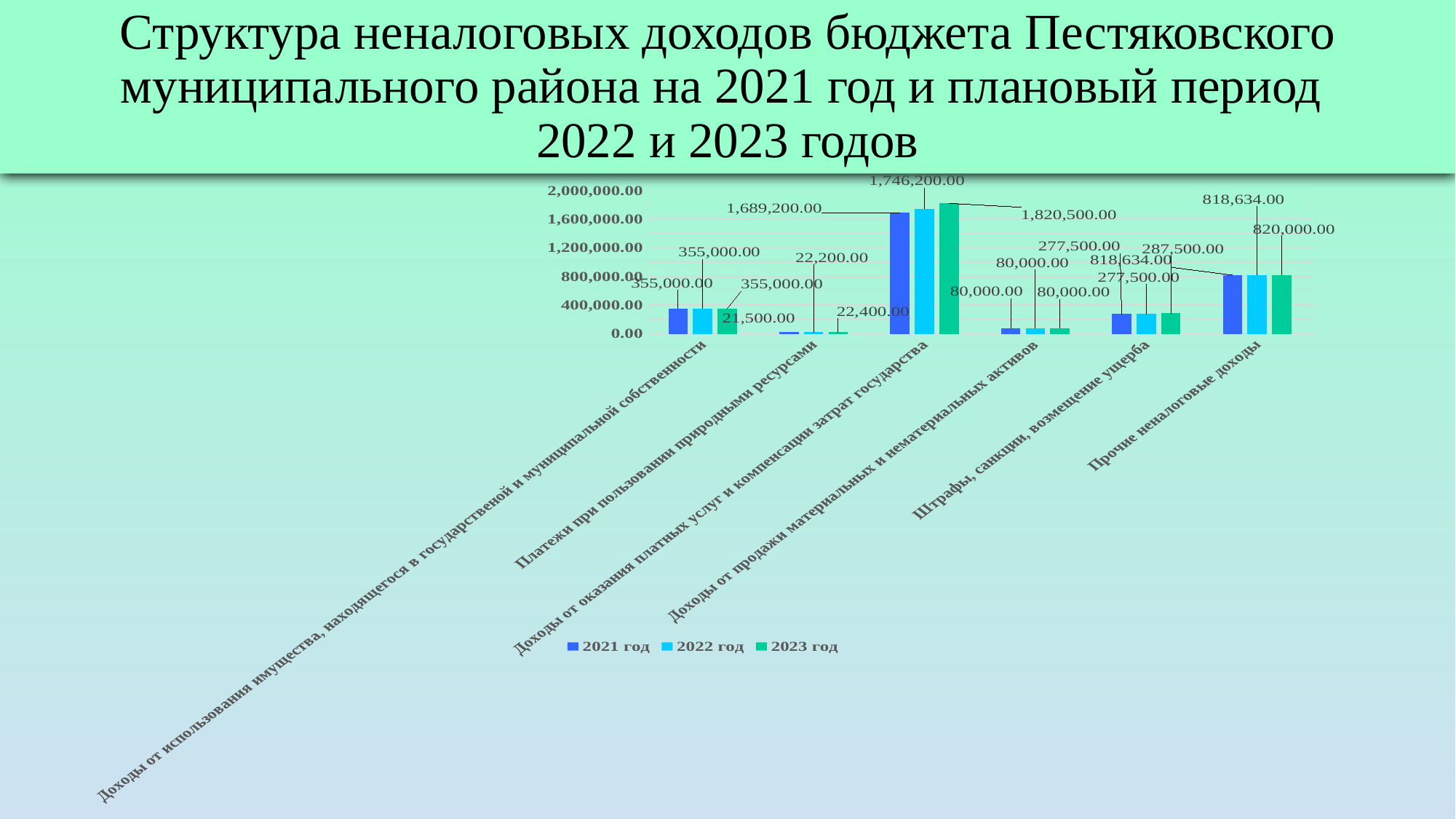
What is the value for 'Прочие неналоговые доходы' in the 2022 год series? 818,634.00 Which category has the highest value in the 2021 год series? Доходы от оказания платных услуг и компенсации затрат государства What is the value for 'Доходы от оказания платных услуг и компенсации затрат государства' in the 2023 год series? 1,820,500.00 How many series does the legend list? 3 Which legend entry is shown in dark blue? 2021 год How many categories are shown on the x axis? 6 What is the value for 'Платежи при пользовании природными ресурсами' in the 2021 год series? 21,500.00 What is the value for 'Штрафы, санкции, возмещение ущерба' in the 2023 год series? 287,500.00 What is the difference between the 2023 год and 2021 год values for 'Доходы от оказания платных услуг и компенсации затрат государства'? 131,300.00 Which category has the lowest value in the 2022 год series? Платежи при пользовании природными ресурсами Which is larger: the 2021 год value for 'Прочие неналоговые доходы' or the 2021 год value for 'Доходы от использования имущества, находящегося в государственной и муниципальной собственности'? Прочие неналоговые доходы What kind of chart is shown on the slide? bar chart